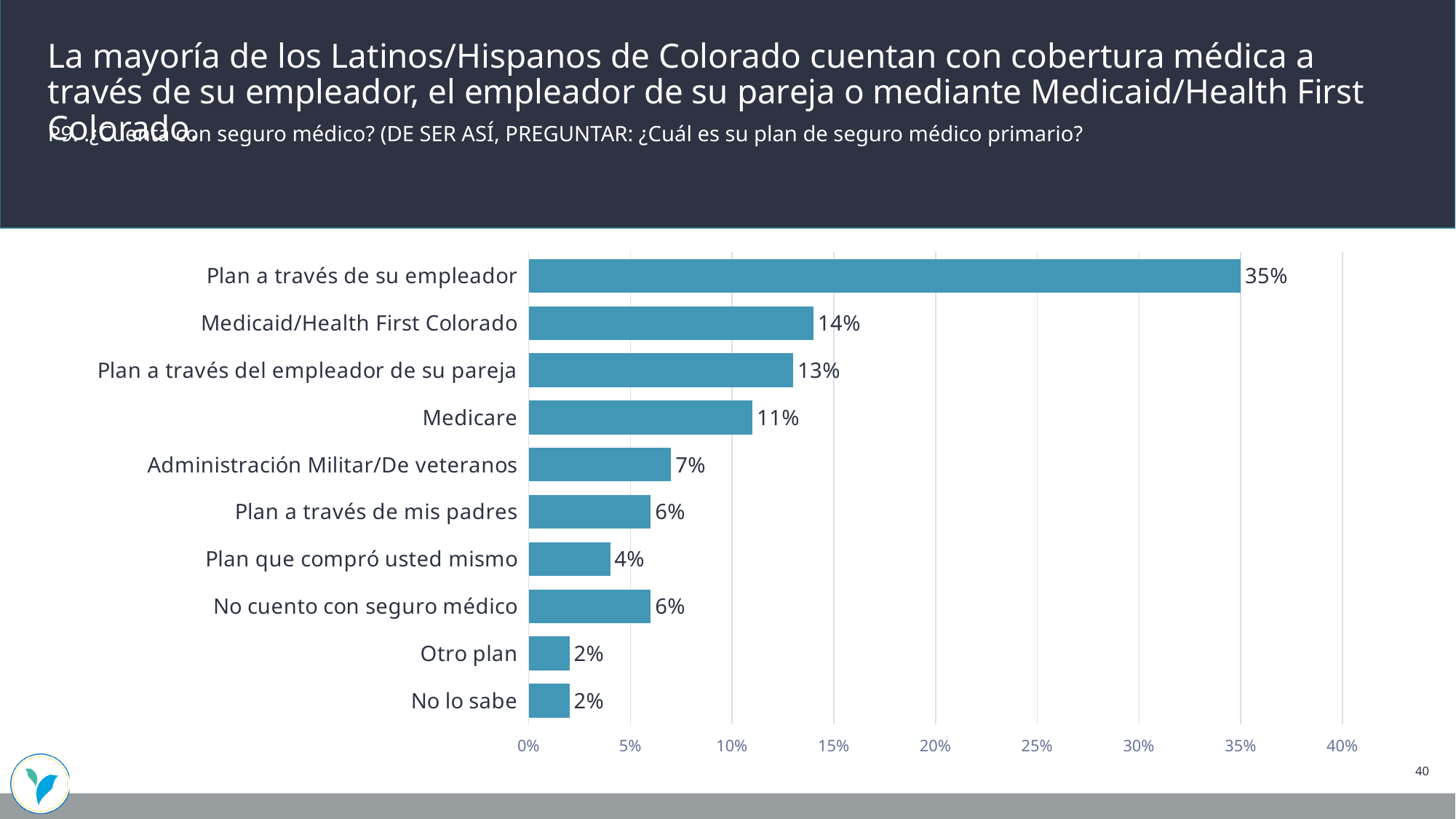
What kind of chart is shown on the slide? Bar chart What is the value for "Plan que compró usted mismo"? 4% Which is larger, "Plan a través del empleador de su pareja" or "Medicare"? Plan a través del empleador de su pareja What is the value for "Plan a través de su empleador"? 35% What is the difference between "Plan a través de su empleador" and "Medicaid/Health First Colorado"? 21% What is the difference between "Medicare" and "Administración Militar/De veteranos"? 4% Which category has the highest value? Plan a través de su empleador What is the value for "Medicare"? 11% How many categories are shown in the chart? 10 What is the value for "Medicaid/Health First Colorado"? 14% Which is larger, "No cuento con seguro médico" or "Plan que compró usted mismo"? No cuento con seguro médico What is the highest value shown on the x axis? 40%